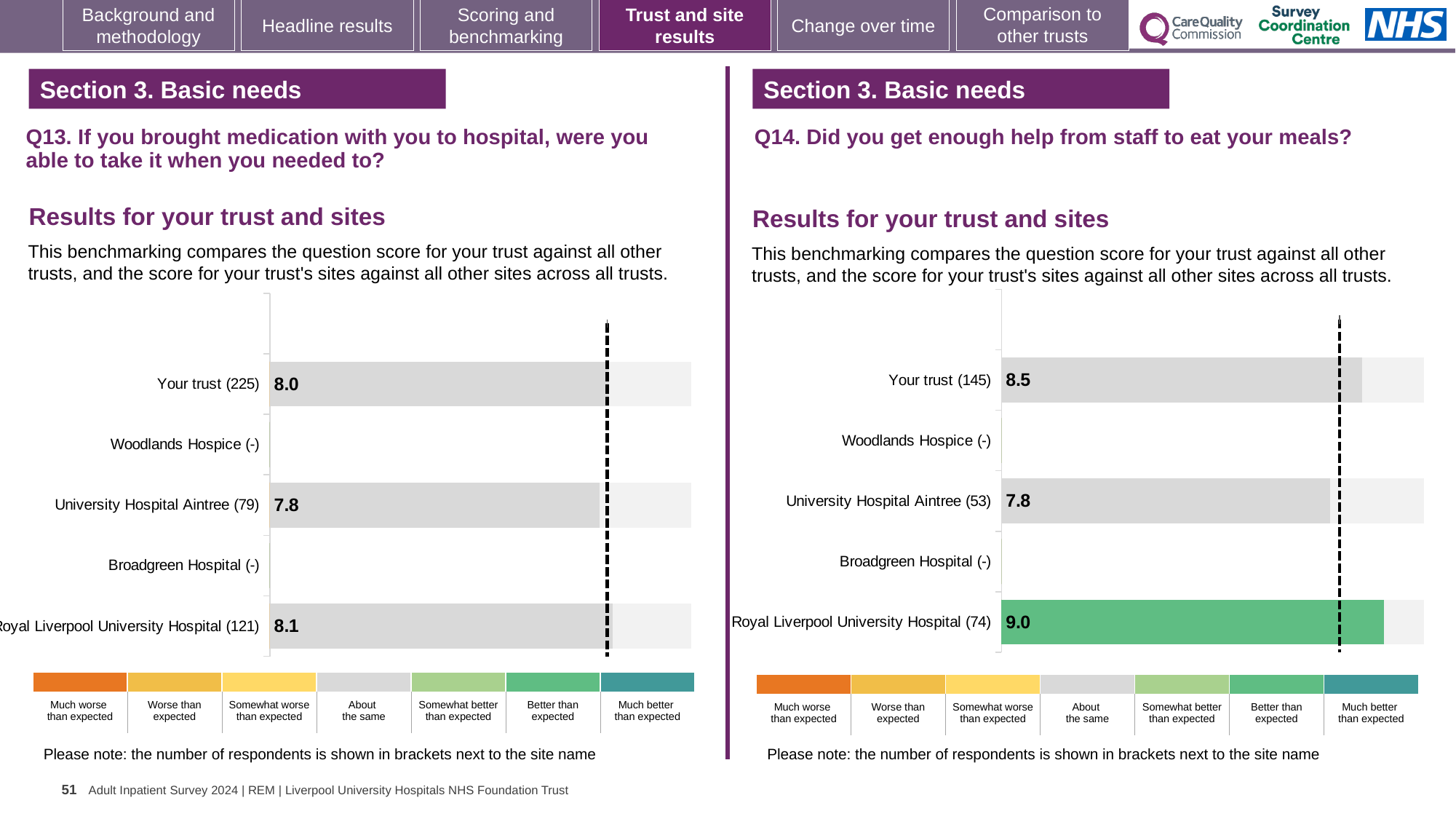
In the Q13 chart on the left, what is the score for University Hospital Aintree (79)? 7.8 In the Q14 chart on the right, which site with a plotted score has the lowest score? University Hospital Aintree (53) In the Q13 chart on the left, what is the score for Royal Liverpool University Hospital (121)? 8.1 In the Q14 chart on the right, what is the difference between the scores for Royal Liverpool University Hospital (74) and University Hospital Aintree (53)? 1.2 In the Q13 chart on the left, which has the larger score: Your trust (225) or University Hospital Aintree (79)? Your trust (225) In the Q13 chart on the left, what is the score for Your trust (225)? 8.0 In the Q14 chart on the right, what is the score for Royal Liverpool University Hospital (74)? 9.0 In the Q14 chart on the right, what is the score for Your trust (145)? 8.5 In the Q14 chart on the right, which site has the highest score? Royal Liverpool University Hospital (74) In the Q13 chart on the left, how many site or trust categories are listed on the axis? 5 What type of chart is used in the Q14 chart on the right? Bar chart In the Q14 chart on the right, what colour is the bar for Royal Liverpool University Hospital (74)? Green